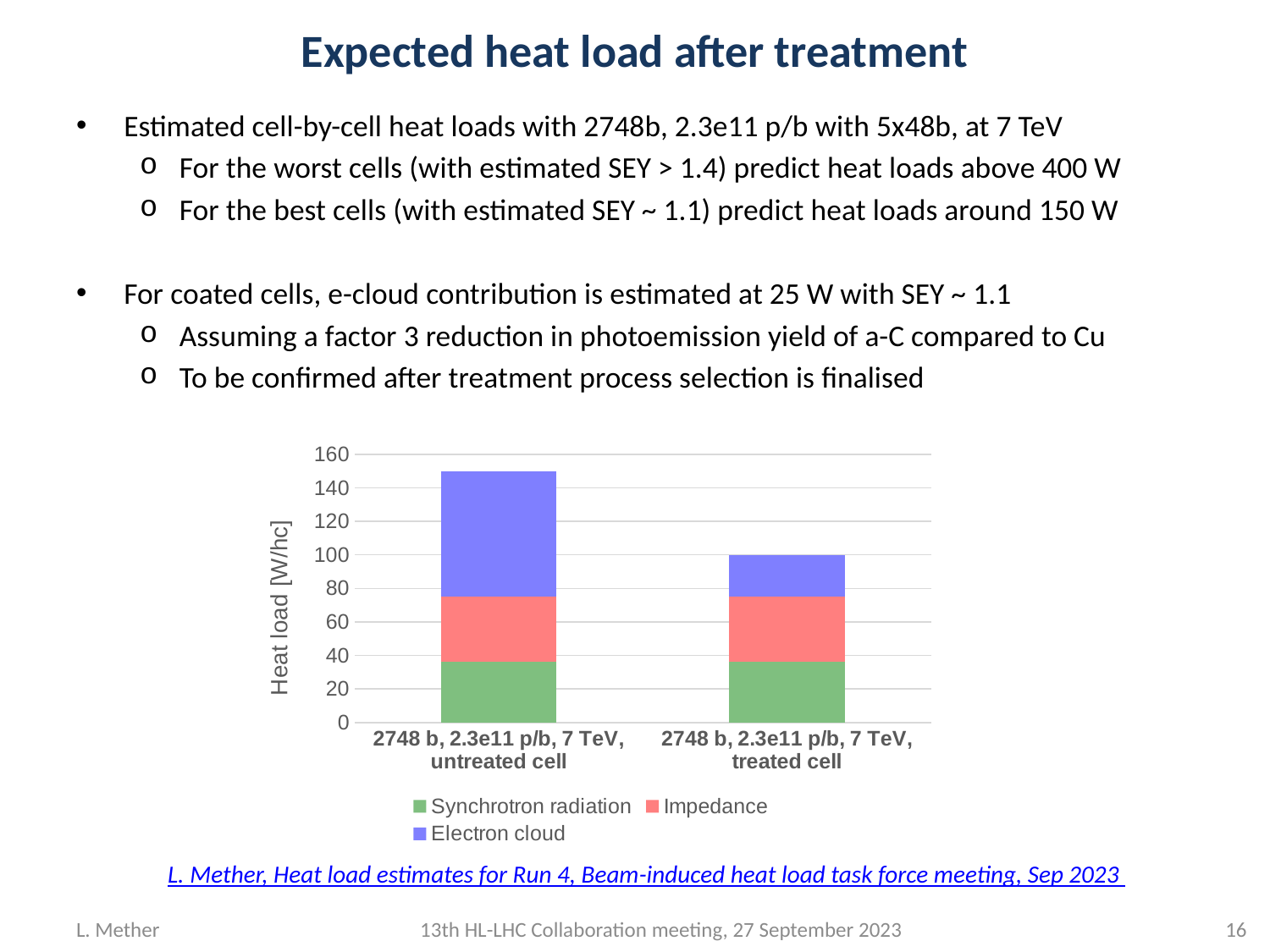
Is the total heat load for the treated cell greater or less than 120? less How many series does the chart legend list? 3 Which colour represents Electron cloud in the chart? blue What is the label of the y axis of the chart? Heat load [W/hc] What kind of chart is shown on the slide? bar chart How many categories are shown on the x axis of the chart? 2 Is the Synchrotron radiation contribution for the untreated cell greater or less than 60? less Is the total heat load for the untreated cell greater or less than 140? greater Does the total heat load rise or fall from the untreated cell to the treated cell? fall Which category has the higher total heat load, the untreated cell or the treated cell? untreated cell Is the Electron cloud contribution for the untreated cell larger or smaller than for the treated cell? larger